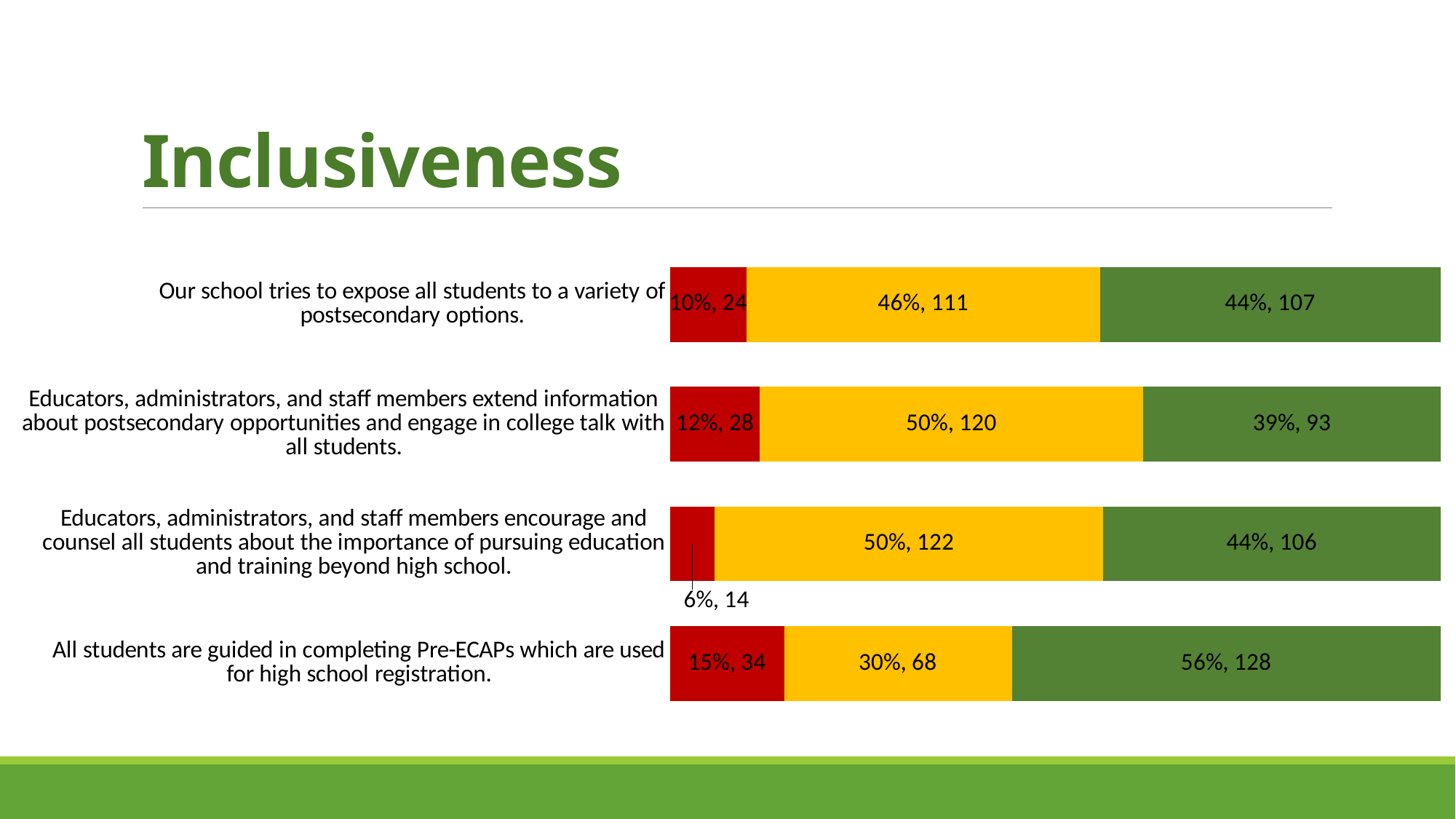
What kind of chart is shown on the slide? Stacked bar chart How many categories (survey statements) are plotted in the chart? 4 Which statement has the largest green segment? All students are guided in completing Pre-ECAPs which are used for high school registration. What is the data label on the green segment for "All students are guided in completing Pre-ECAPs which are used for high school registration."? 56%, 128 What is the data label on the red segment for "Educators, administrators, and staff members encourage and counsel all students about the importance of pursuing education and training beyond high school."? 6%, 14 Which statement has the smallest red segment? Educators, administrators, and staff members encourage and counsel all students about the importance of pursuing education and training beyond high school. Which has a larger green count: "Our school tries to expose all students to a variety of postsecondary options." or "Educators, administrators, and staff members extend information about postsecondary opportunities and engage in college talk with all students."? Our school tries to expose all students to a variety of postsecondary options. What is the title of the slide containing the chart? Inclusiveness What is the data label on the yellow segment for "Our school tries to expose all students to a variety of postsecondary options."? 46%, 111 What is the difference between the yellow count for "Educators, administrators, and staff members extend information about postsecondary opportunities and engage in college talk with all students." (120) and the yellow count for "All students are guided in completing Pre-ECAPs which are used for high school registration." (68)? 52 What three colours are used for the segments of each bar? Red, yellow and green What is the total count across all three segments for "All students are guided in completing Pre-ECAPs which are used for high school registration."? 230